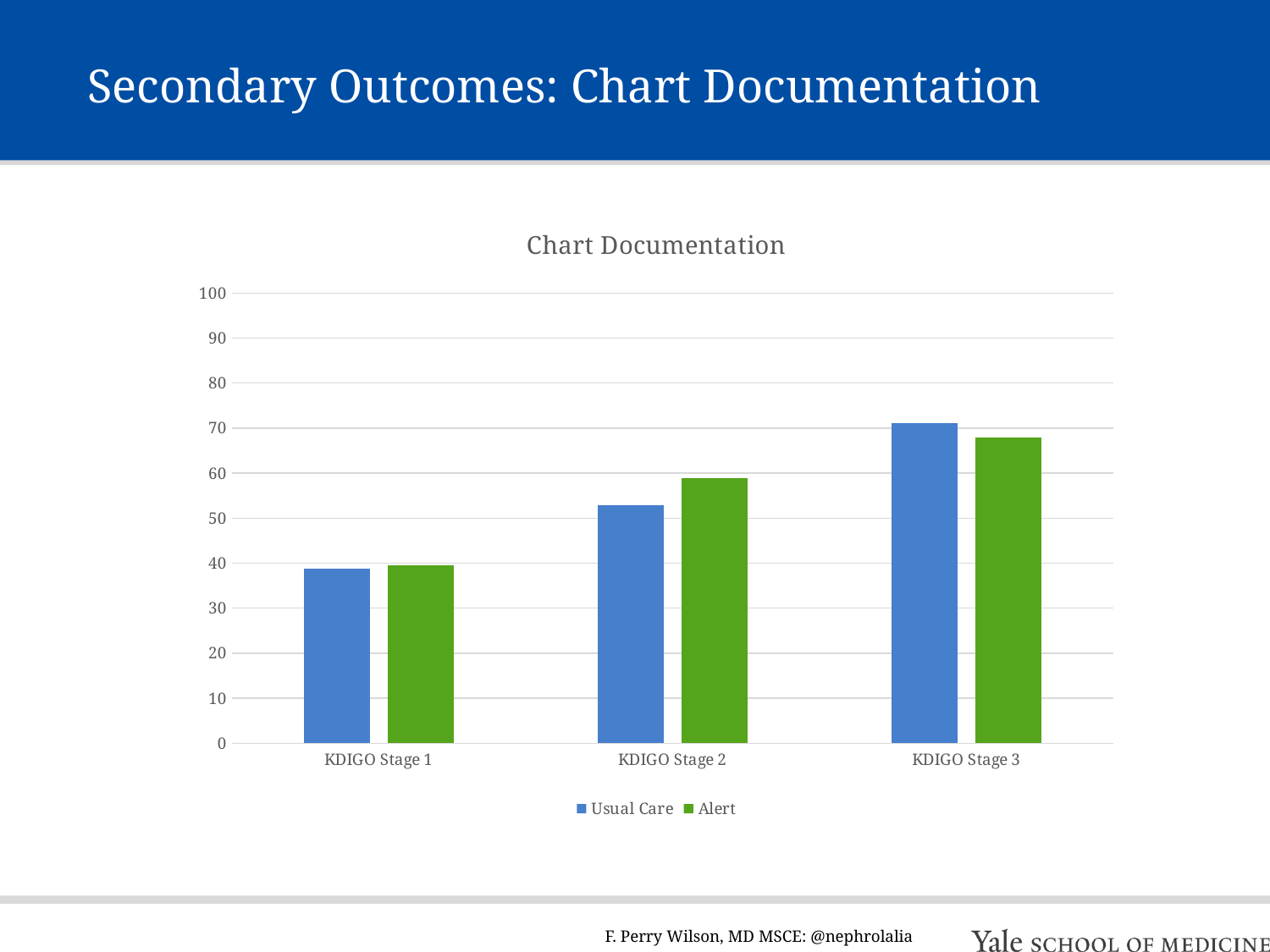
How many series does the legend list? 2 Is the Alert value for KDIGO Stage 1 greater or less than 50? less What kind of chart is shown on the slide? bar chart For which category is the Usual Care value highest? KDIGO Stage 3 For which category is the Alert value lowest? KDIGO Stage 1 Do the Usual Care values rise or fall from KDIGO Stage 1 to KDIGO Stage 3? rise What is the title of the chart? Chart Documentation For KDIGO Stage 3, which is larger: Usual Care or Alert? Usual Care How many categories are shown on the x axis? 3 For KDIGO Stage 2, which is larger: Usual Care or Alert? Alert Which series is shown in green? Alert